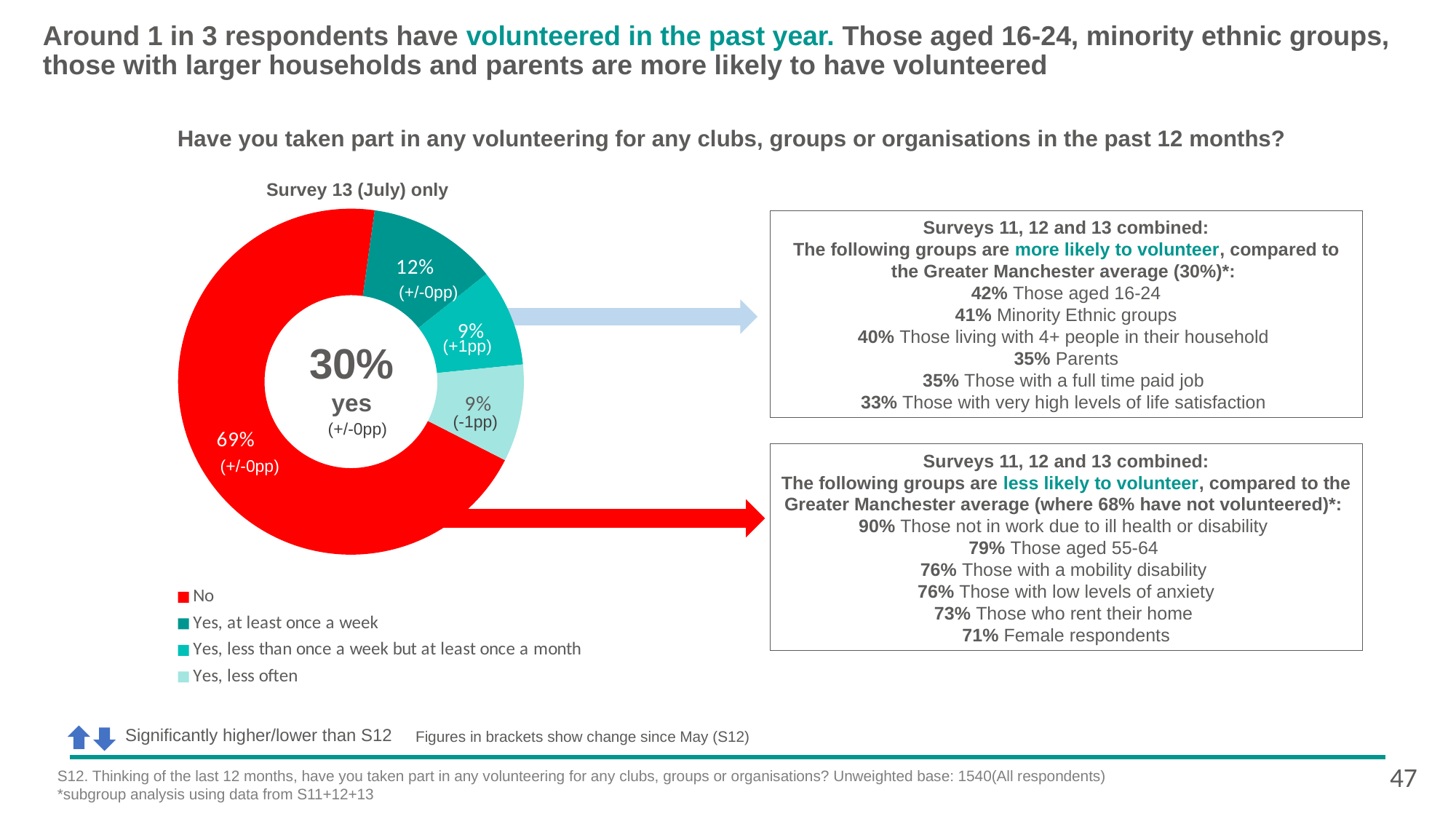
What percentage is shown in the centre of the donut chart for "yes"? 30% What percentage of respondents answered "Yes, less often"? 9% Which survey does the donut chart cover, according to its label? Survey 13 (July) only What is the difference in percentage points between "No" and "Yes, at least once a week"? 57 percentage points What percentage of respondents answered "No" in the donut chart? 69% What percentage of respondents answered "Yes, at least once a week"? 12% What kind of chart is shown on the slide? Pie chart (donut) What change since May (S12) is shown in brackets for the "Yes, less than once a week but at least once a month" slice? +1pp Which is larger: the share for "Yes, at least once a week" or the share for "Yes, less often"? Yes, at least once a week How many categories does the legend of the donut chart list? 4 Which category has the largest share of the donut chart? No What colour is the "No" slice in the donut chart? Red